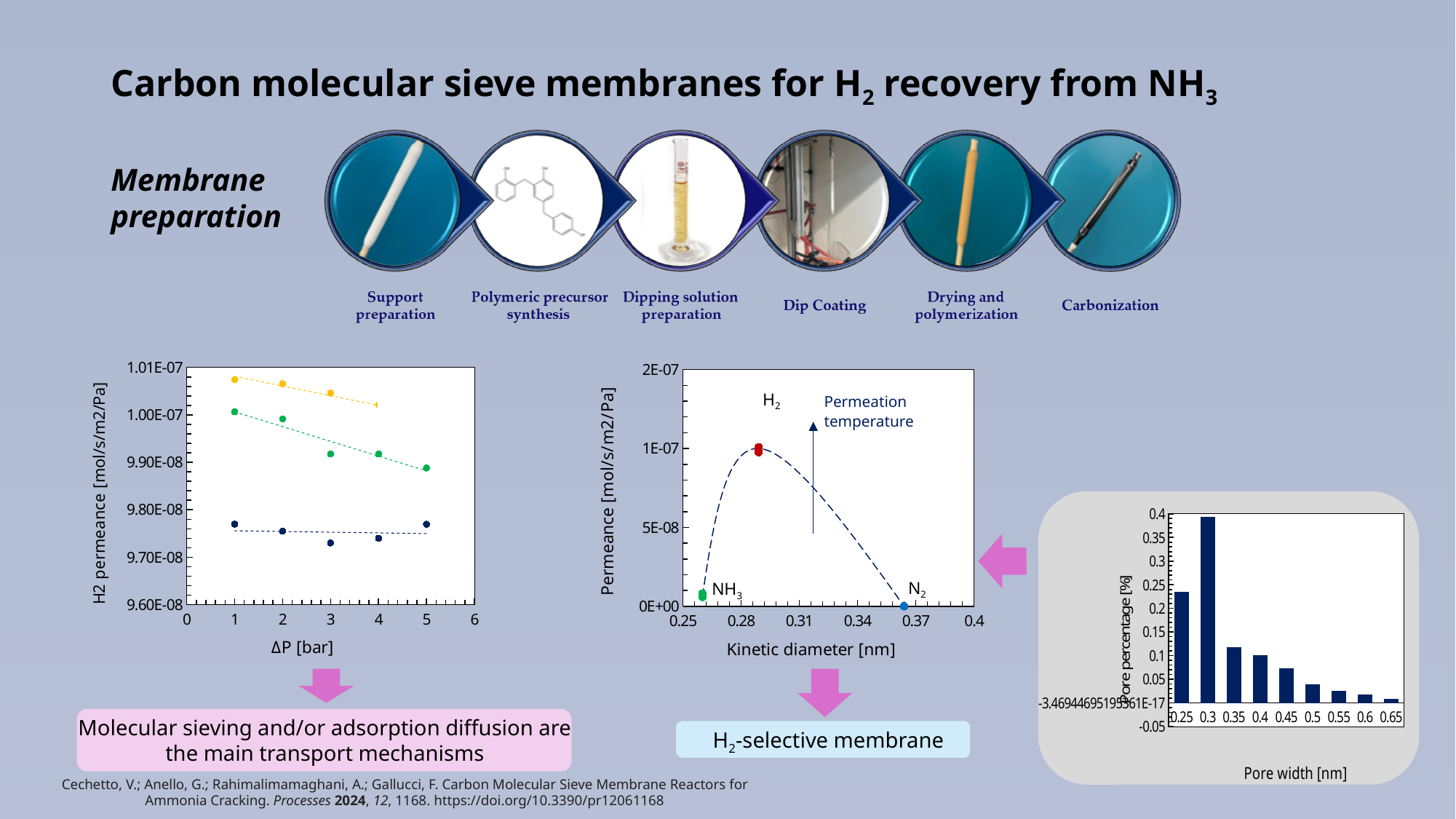
In the left chart of H2 permeance versus ΔP, is the value of the blue series at ΔP = 3 bar greater or less than 9.80E-08? less In the middle chart of Permeance versus Kinetic diameter, which gas has the highest permeance? H2 In the Pore width bar chart on the right, which has the larger pore percentage, pore width 0.25 or pore width 0.35? 0.25 In the Pore width bar chart on the right, which pore width has the highest pore percentage? 0.3 In the middle chart of Permeance versus Kinetic diameter, which gas has the lowest permeance? N2 In the Pore width bar chart on the right, is the pore percentage for pore width 0.3 greater or less than 0.35? greater In the Pore width bar chart on the right, do the pore percentages generally rise or fall as pore width increases beyond 0.3? fall In the left chart of H2 permeance versus ΔP, does the yellow series rise or fall as ΔP increases? fall In the Pore width bar chart on the right, how many pore width categories are shown on the x axis? 9 In the Pore width bar chart on the right, which pore width has the lowest pore percentage? 0.65 In the middle chart of Permeance versus Kinetic diameter, is the permeance for NH3 greater or less than 5E-08? less What kind of chart is the chart on the right with the x axis labelled Pore width [nm]? bar chart